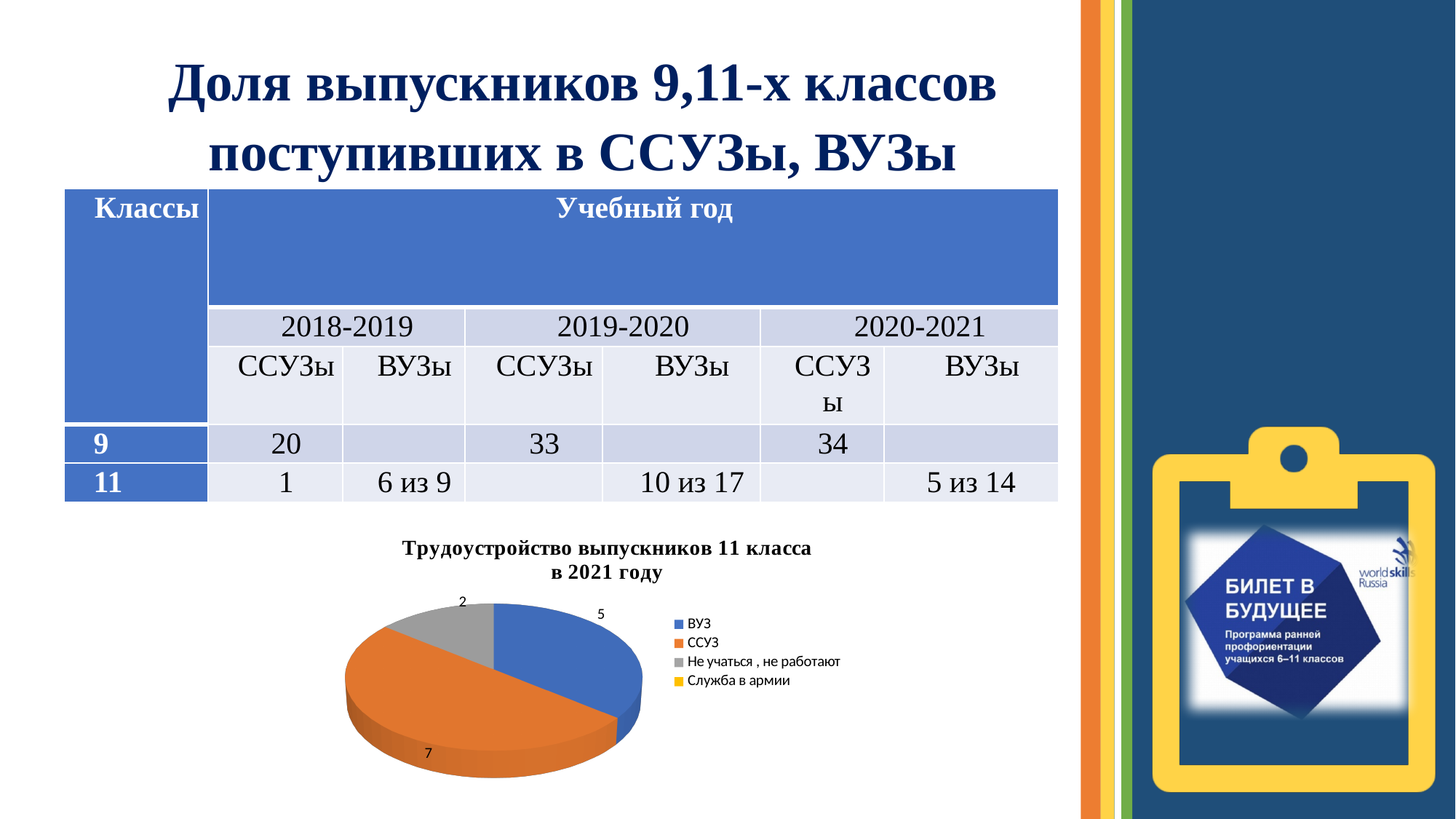
In the pie chart, what is the value for ССУЗ? 7 How many categories does the legend of the pie chart list? 4 In the pie chart, which is larger: the value for ВУЗ or the value for 'Не учаться , не работают'? ВУЗ In the pie chart, what is the value for ВУЗ? 5 Which category has the largest slice in the pie chart? ССУЗ Among the labelled slices in the pie chart, which category has the smallest value? Не учаться , не работают What is the title of the pie chart? Трудоустройство выпускников 11 класса в 2021 году In the pie chart, which is larger: the value for ССУЗ or the value for ВУЗ? ССУЗ In the pie chart, what is the difference between the values for ССУЗ and ВУЗ? 2 What colour is the ССУЗ slice in the pie chart? orange In the pie chart, what is the value for 'Не учаться , не работают'? 2 What kind of chart is shown under the title 'Трудоустройство выпускников 11 класса в 2021 году'? pie chart